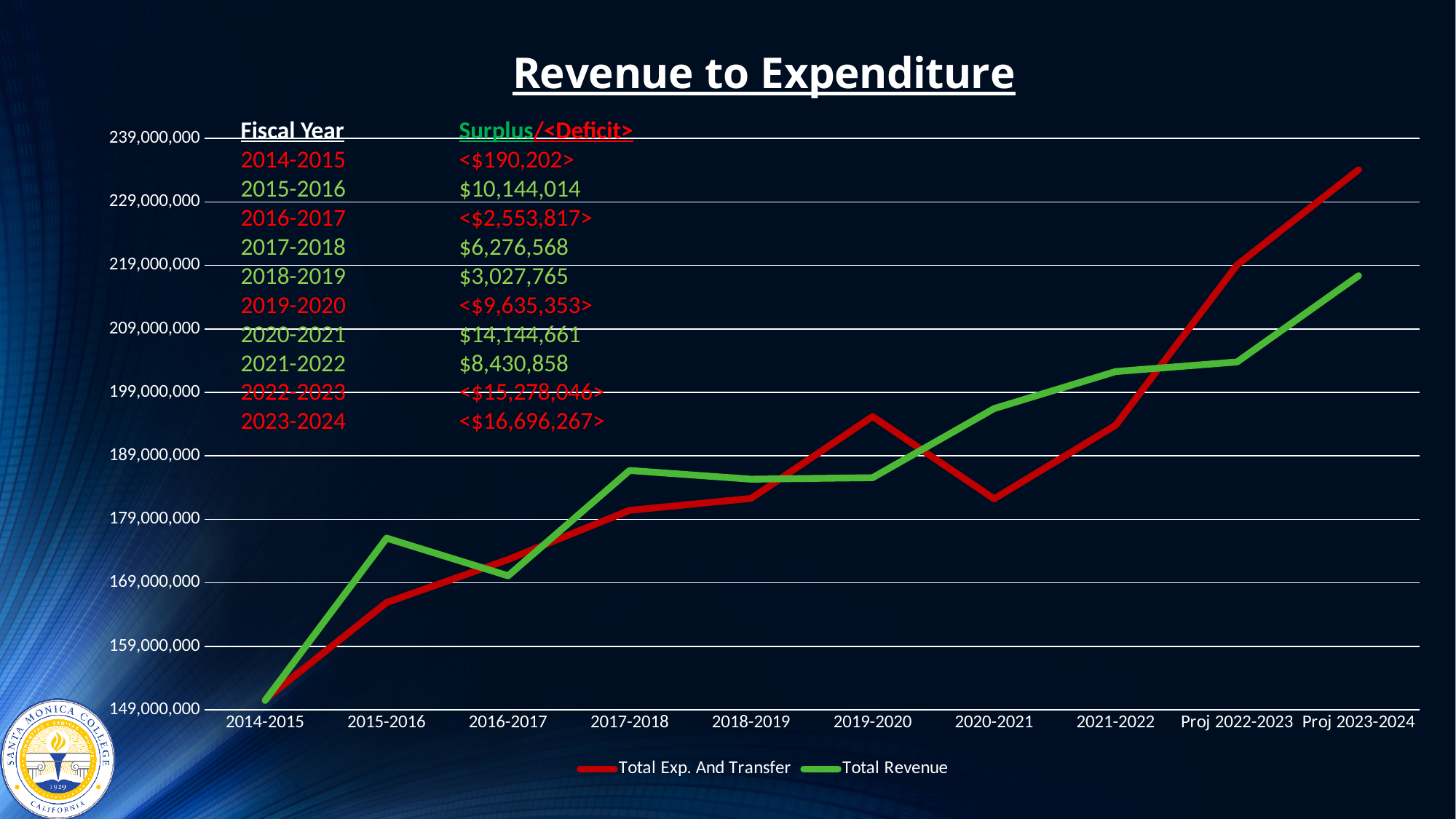
How many fiscal years are plotted along the x axis? 10 What kind of chart is shown on the slide? line chart In 2020-2021, which is larger: Total Revenue or Total Exp. And Transfer? Total Revenue In which fiscal year is Total Exp. And Transfer at its highest? Proj 2023-2024 Which colour is used for the Total Revenue line? green What is the title of the chart? Revenue to Expenditure How many series does the legend list? 2 In which fiscal year is Total Revenue at its lowest? 2014-2015 Is the Total Revenue value for Proj 2023-2024 greater or less than 219,000,000? less In 2019-2020, which is larger: Total Exp. And Transfer or Total Revenue? Total Exp. And Transfer Does Total Revenue generally rise or fall from 2014-2015 to Proj 2023-2024? rise Is the Total Exp. And Transfer value for Proj 2023-2024 greater or less than 229,000,000? greater